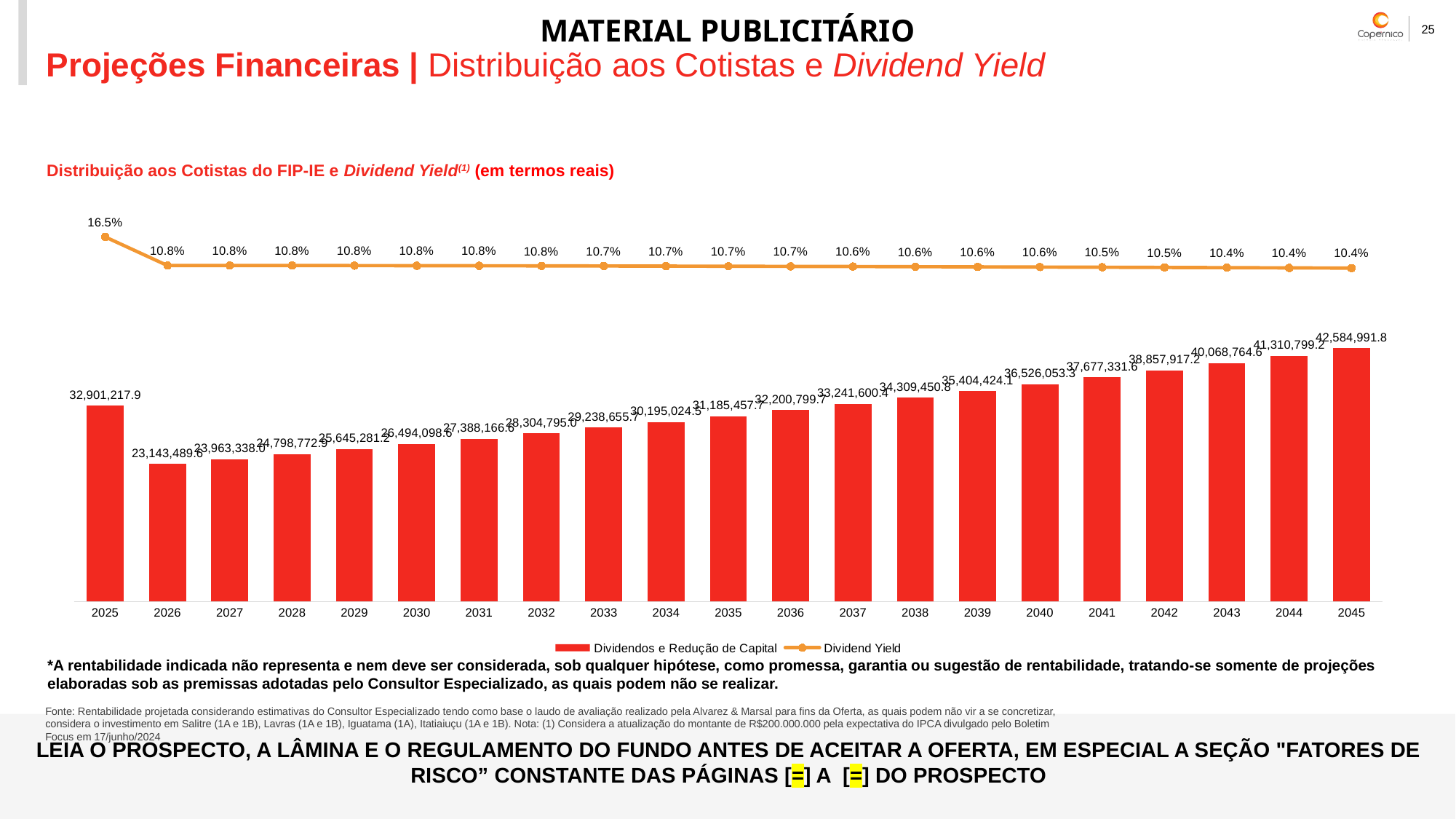
What is the Dividend Yield shown for 2040? 10.6% Does the Dividend Yield rise or fall from 2026 to 2045? Fall What is the difference between the Dividendos e Redução de Capital values for 2045 and 2044? 1,274,192.6 How many years are shown on the x axis of the chart? 21 What kind of chart is shown on the slide? A combined bar and line chart Which year has the lowest value of Dividendos e Redução de Capital? 2026 What is the Dividend Yield shown for 2025? 16.5% Which year has a larger Dividendos e Redução de Capital value, 2025 or 2036? 2025 How many series does the legend list? 2 Which year has the highest value of Dividendos e Redução de Capital? 2045 What is the value of Dividendos e Redução de Capital for 2045? 42,584,991.8 What is the value of Dividendos e Redução de Capital for 2035? 31,185,457.7